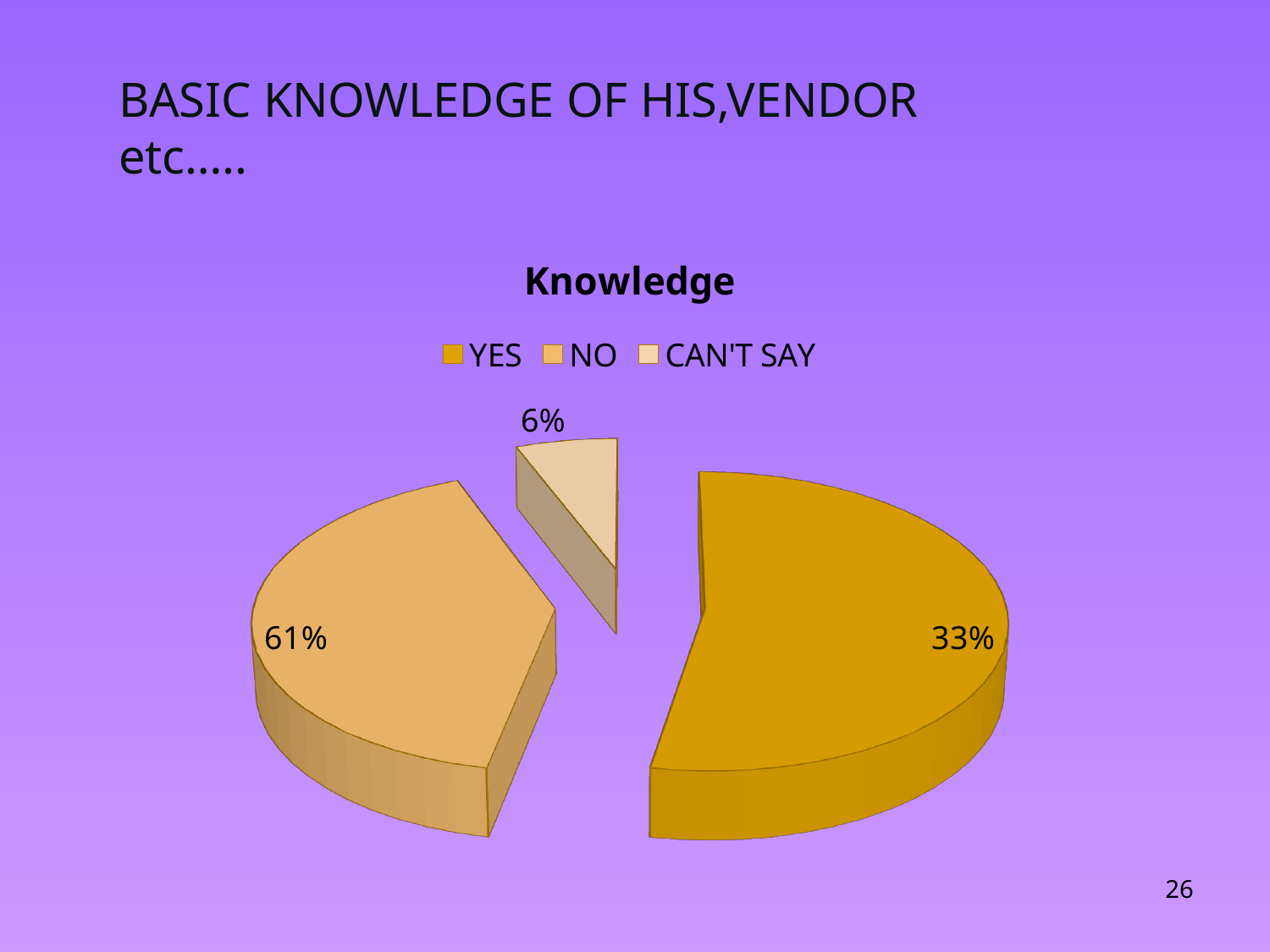
What is the title of the chart? Knowledge How many categories does the legend of the pie chart list? 3 Is the share for CAN'T SAY greater or less than 10%? less Which category has the smallest share of the pie? CAN'T SAY How many slices does the pie chart have? 3 What type of chart is shown on the slide? pie chart Which legend entry is listed first in the chart legend? YES Which is larger, the share for YES or the share for CAN'T SAY? YES What percentage label appears on the NO slice? 61% What percentage label appears on the YES slice? 33% What percentage is shown for the CAN'T SAY slice? 6%